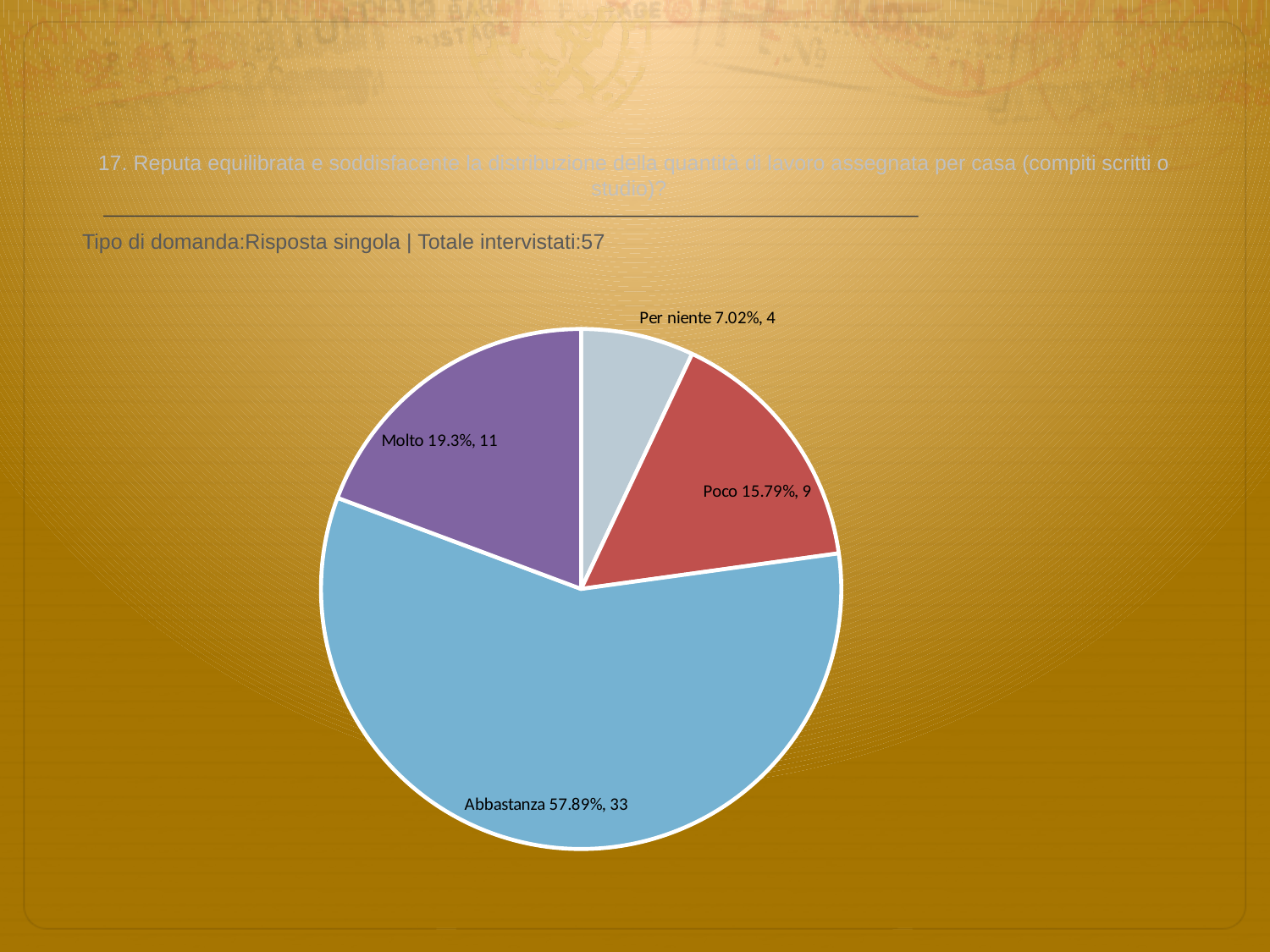
What percentage share does the Poco slice have? 15.79% Which has more respondents, Poco or Molto? Molto Which category has the largest slice? Abbastanza What is the total number of respondents across all slices? 57 What colour is the Abbastanza slice? light blue How many respondents answered Molto? 11 What percentage share does the Abbastanza slice have? 57.89% What kind of chart is shown on the slide? pie chart How many slices does the pie chart have? 4 What is the difference in respondent count between Abbastanza and Molto? 22 How many respondents answered Per niente? 4 Which category has the smallest slice? Per niente